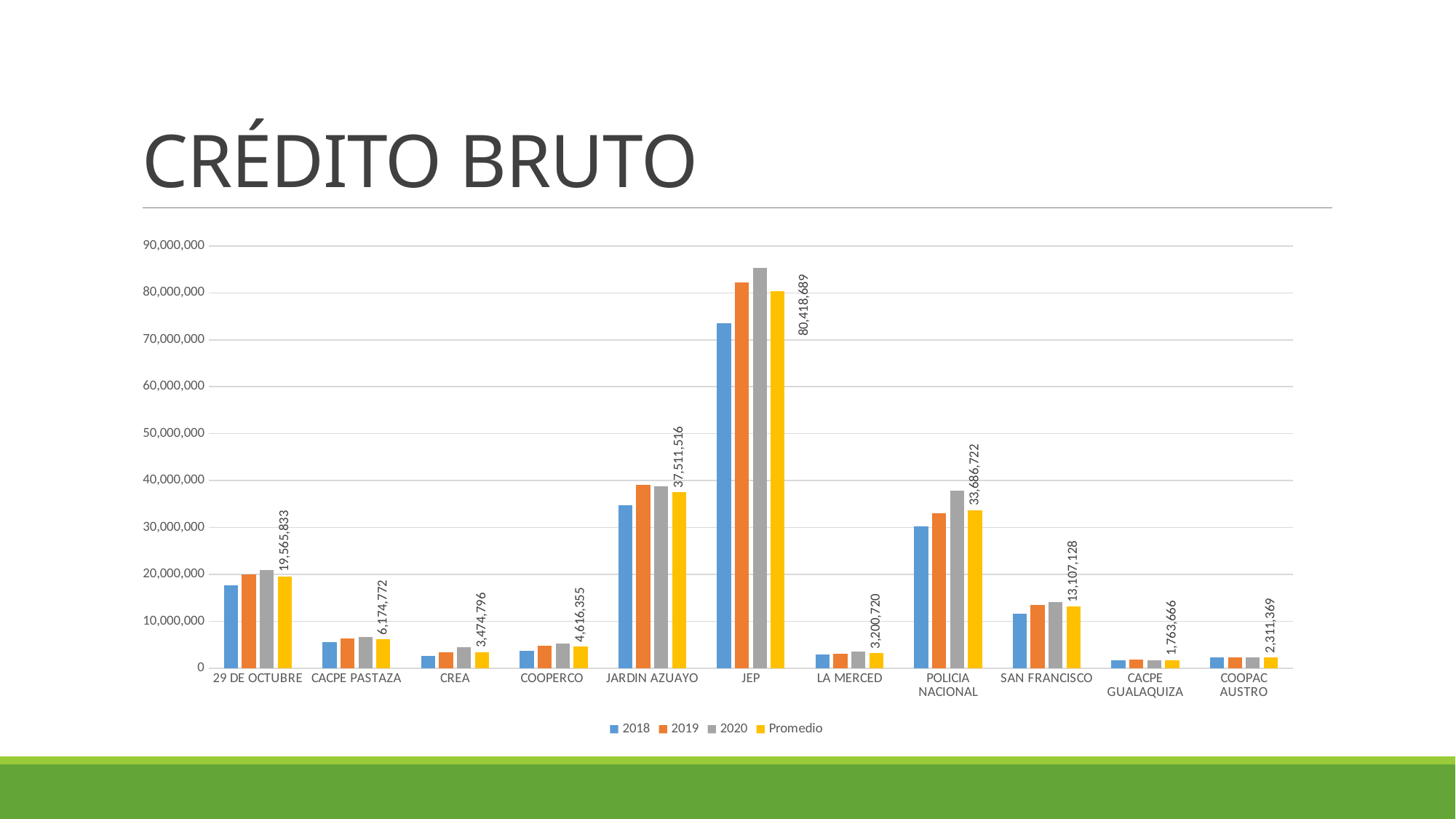
What is the Promedio value for JEP? 80,418,689 What is the Promedio value for CACPE GUALAQUIZA? 1,763,666 What is the difference between the Promedio values for POLICIA NACIONAL and SAN FRANCISCO? 20,579,594 What type of chart is shown on the slide? Bar chart How many series does the legend list? 4 Which has a larger Promedio value, CREA or COOPERCO? COOPERCO What is the Promedio value for JARDIN AZUAYO? 37,511,516 Is the 2020 value for JEP greater or less than 80,000,000? greater Which category has the highest Promedio value? JEP How many categories are shown on the x axis? 11 Is the 2018 value for 29 DE OCTUBRE greater or less than 20,000,000? less Which category has the lowest Promedio value? CACPE GUALAQUIZA